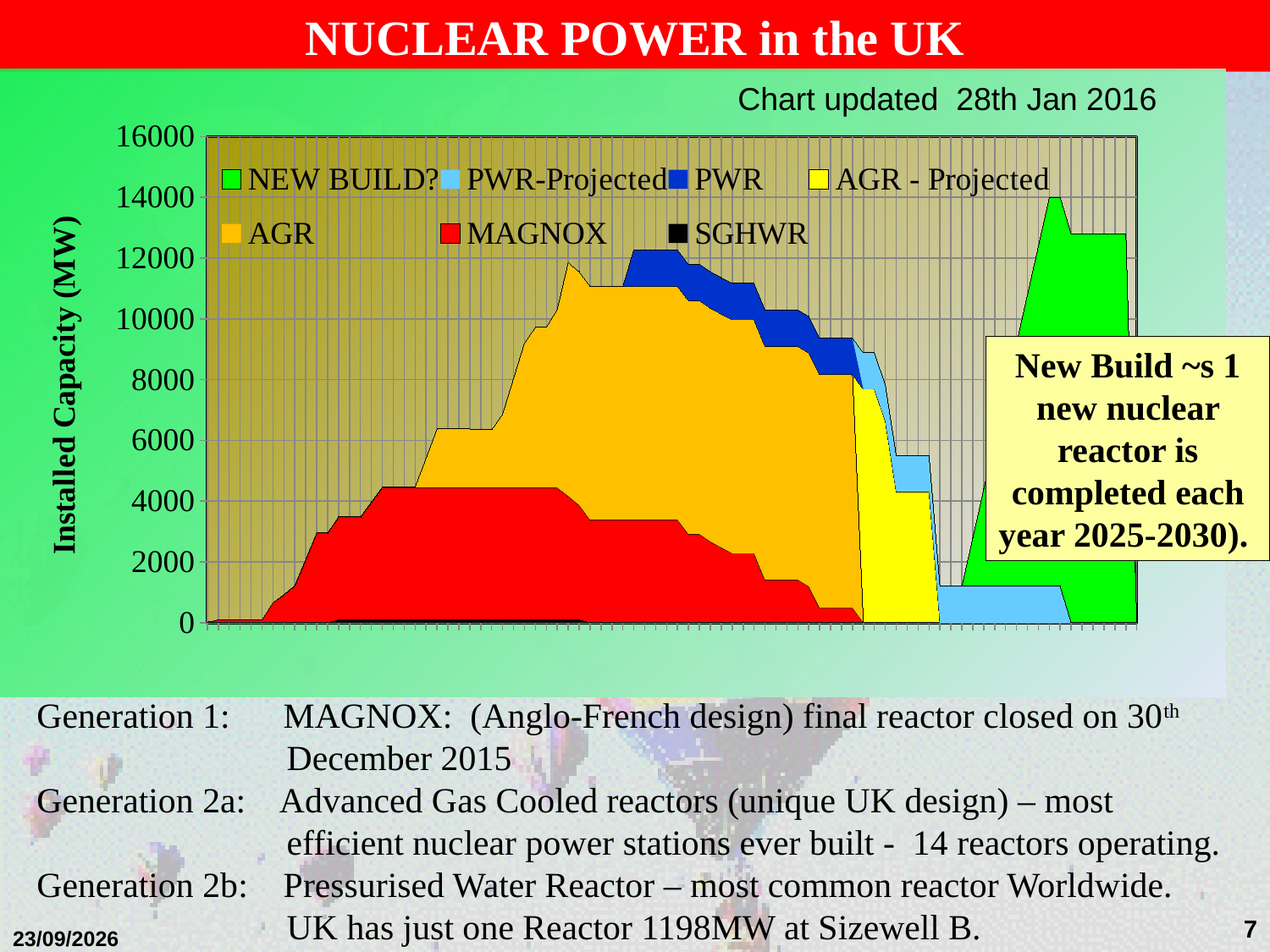
Is the highest point of the total stacked capacity (top of the dark blue PWR area) greater or less than 10000? greater How many series does the chart legend list? 7 Is the peak of the red MAGNOX area greater or less than 6000? less What is the label on the vertical axis of the chart? Installed Capacity (MW) Is the peak of the yellow AGR - Projected area greater or less than 6000? greater Which series in the legend is shown in green? NEW BUILD? Which reaches a higher peak, the green NEW BUILD? area or the red MAGNOX area? NEW BUILD? What kind of chart is shown on the slide? Stacked area chart Which reaches a higher peak, the red MAGNOX area or the yellow AGR - Projected area? AGR - Projected